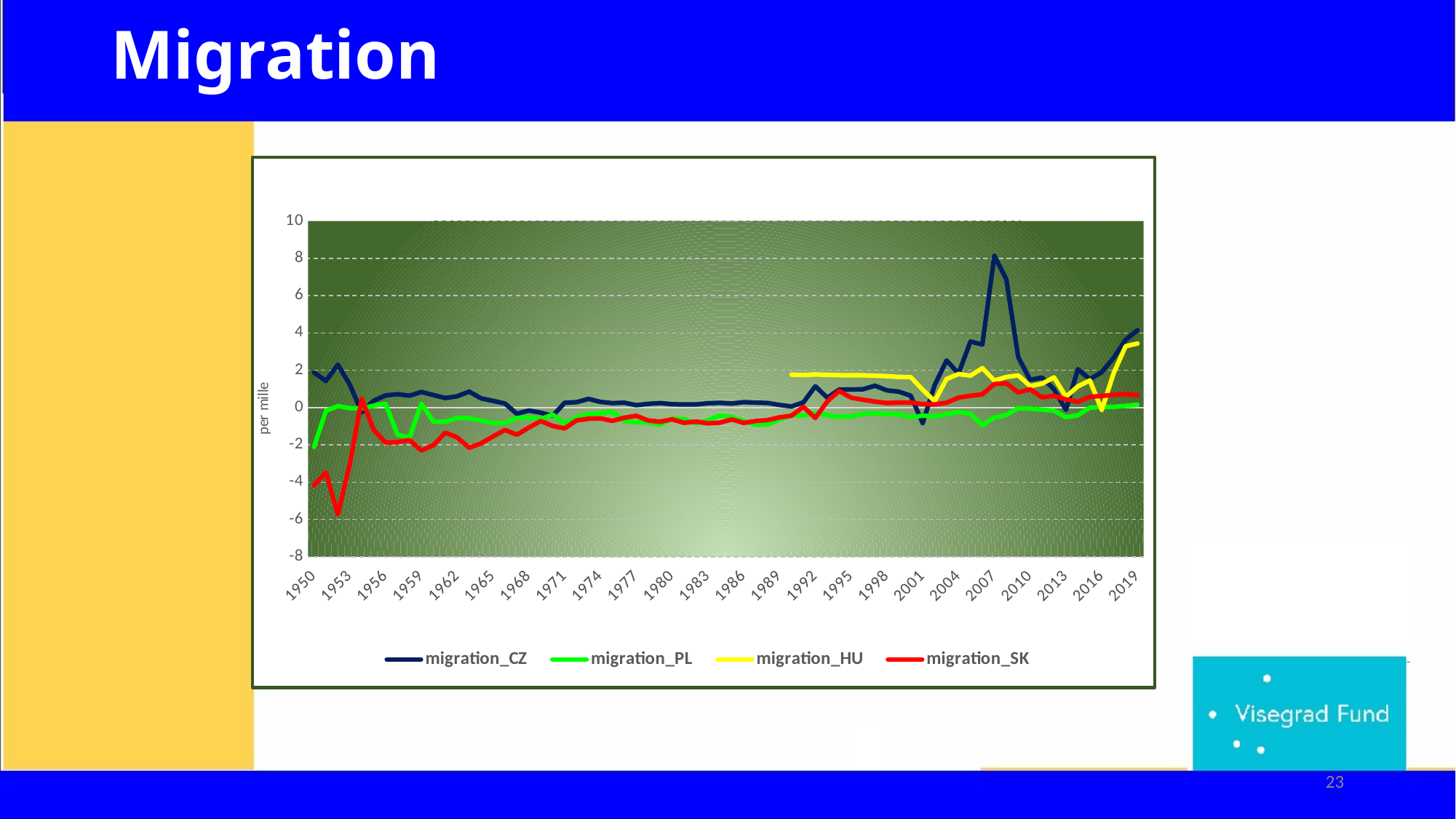
Is the lowest value of migration_SK in the early 1950s greater or less than -4? less Which series reaches the highest value anywhere on the chart? migration_CZ Is the value of migration_HU in 1992 greater or less than 0? greater Is the peak value of migration_CZ around 2008 greater or less than 6? greater Which series reaches the lowest value anywhere on the chart? migration_SK Around 2008, which is higher: migration_CZ or migration_PL? migration_CZ What are the series names listed in the legend? migration_CZ, migration_PL, migration_HU, migration_SK How many series does the legend list? 4 What is the label on the vertical axis? per mille What kind of chart is shown on the slide? line chart Does migration_CZ rise or fall between 2008 and 2010? fall How many year labels are shown on the x axis? 24